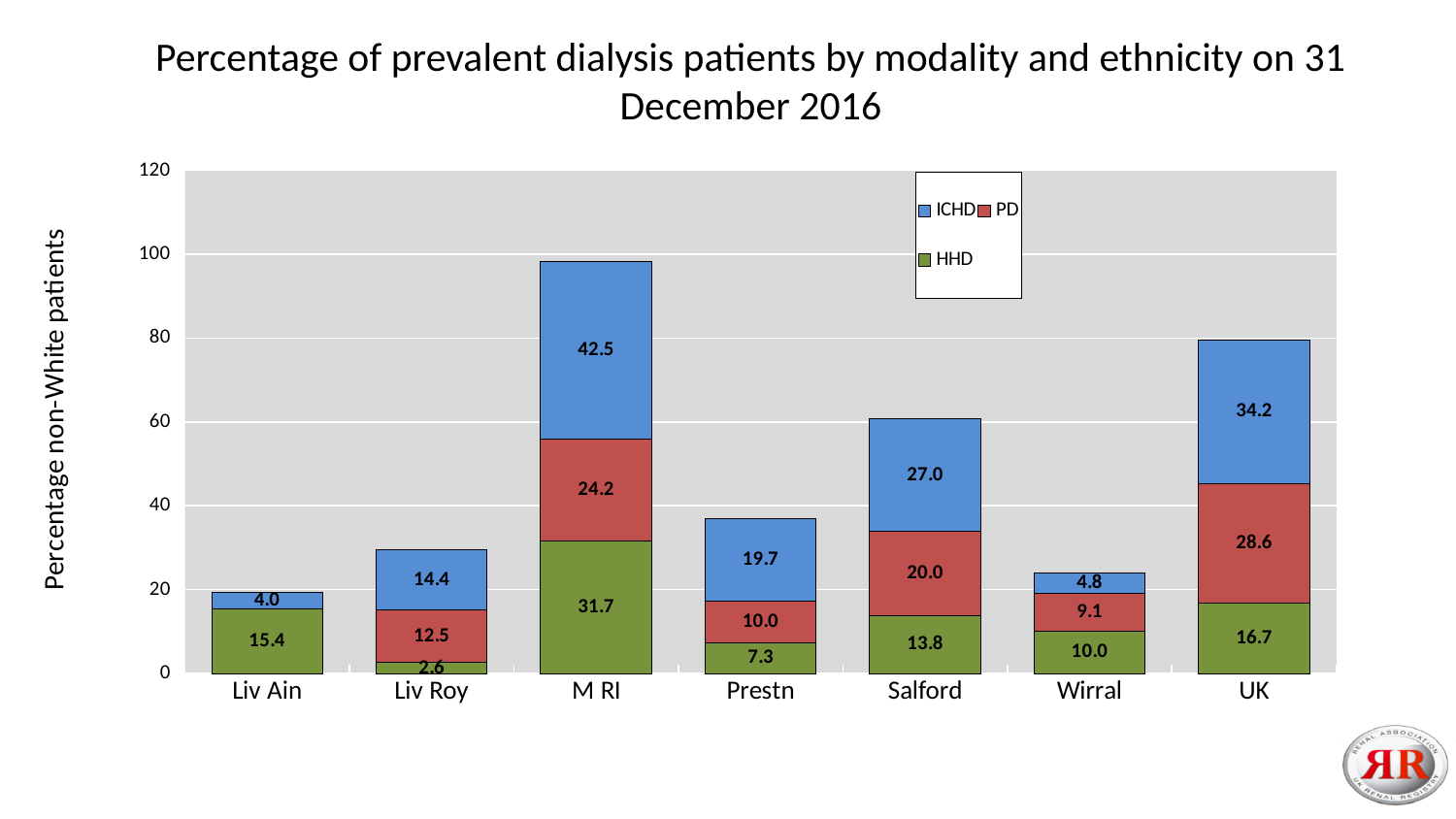
Which centre has the lowest HHD value? Liv Roy Which is larger, the HHD value for Liv Ain or the HHD value for UK? UK What is the total of the stacked bar for Salford? 60.8 What is the HHD value for Salford? 13.8 What is the ICHD value for M RI? 42.5 What is the difference between the PD value for Salford and the PD value for Prestn? 10.0 How many centres are shown on the x axis? 7 What is the PD value for UK? 28.6 What kind of chart is shown on the slide? stacked bar chart Is the total height of the M RI bar greater or less than 80? greater How many series does the legend list? 3 Which centre has the highest ICHD value? M RI